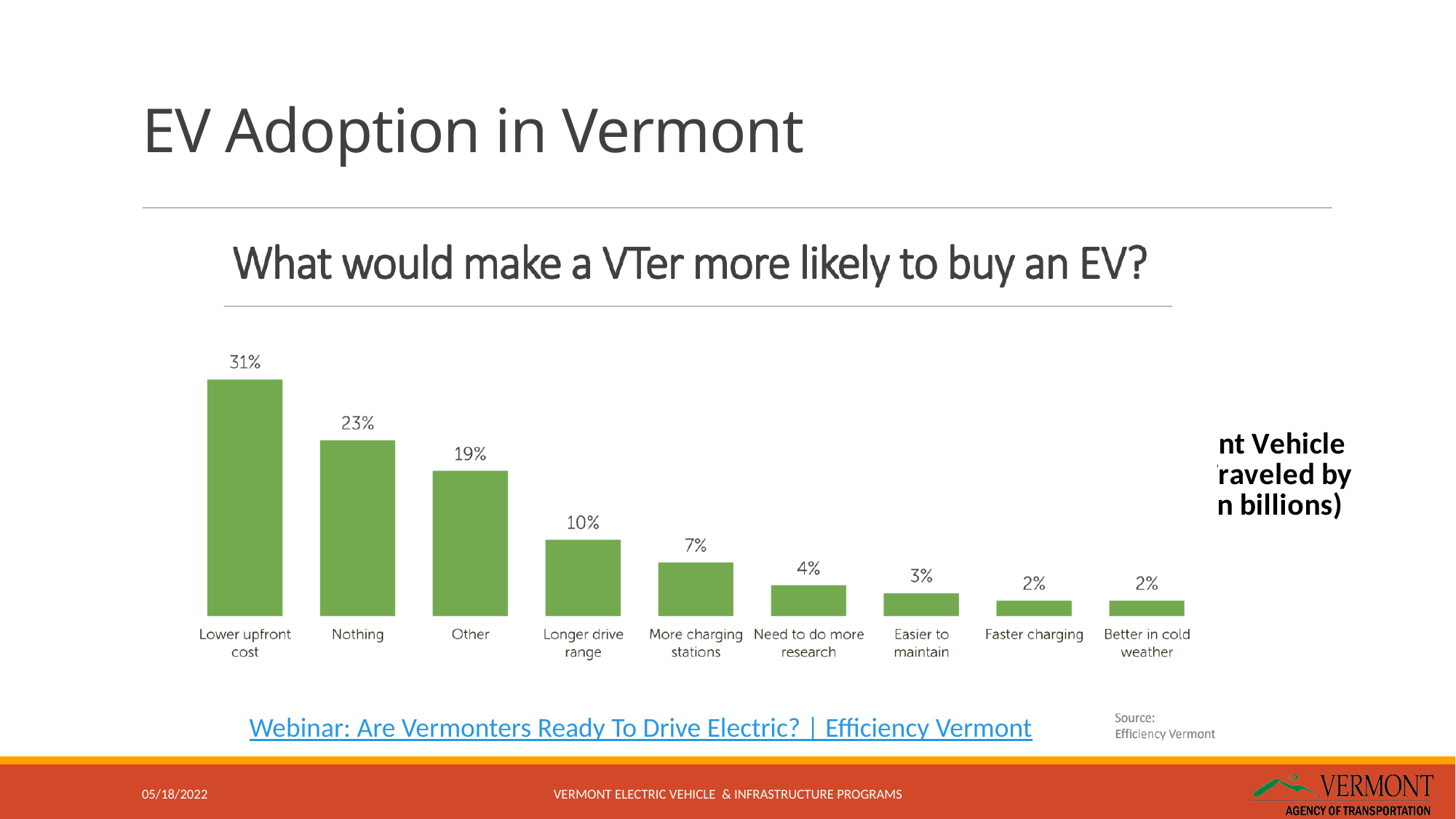
What is the value for 'More charging stations'? 7% What percentage is shown for 'Longer drive range'? 10% Which is larger, the value for 'Other' or the value for 'Longer drive range'? Other Do the values rise or fall moving from left to right along the x axis? Fall What kind of chart is shown on the slide? Bar chart What is the title of the chart? What would make a VTer more likely to buy an EV? What is the difference between the values for 'Lower upfront cost' and 'Nothing'? 8% What is the value for 'Nothing' in the chart? 23% What is the source cited for the chart? Efficiency Vermont What percentage of respondents said a lower upfront cost would make them more likely to buy an EV? 31% Which category has the highest value in the chart? Lower upfront cost How many categories are shown in the chart? 9